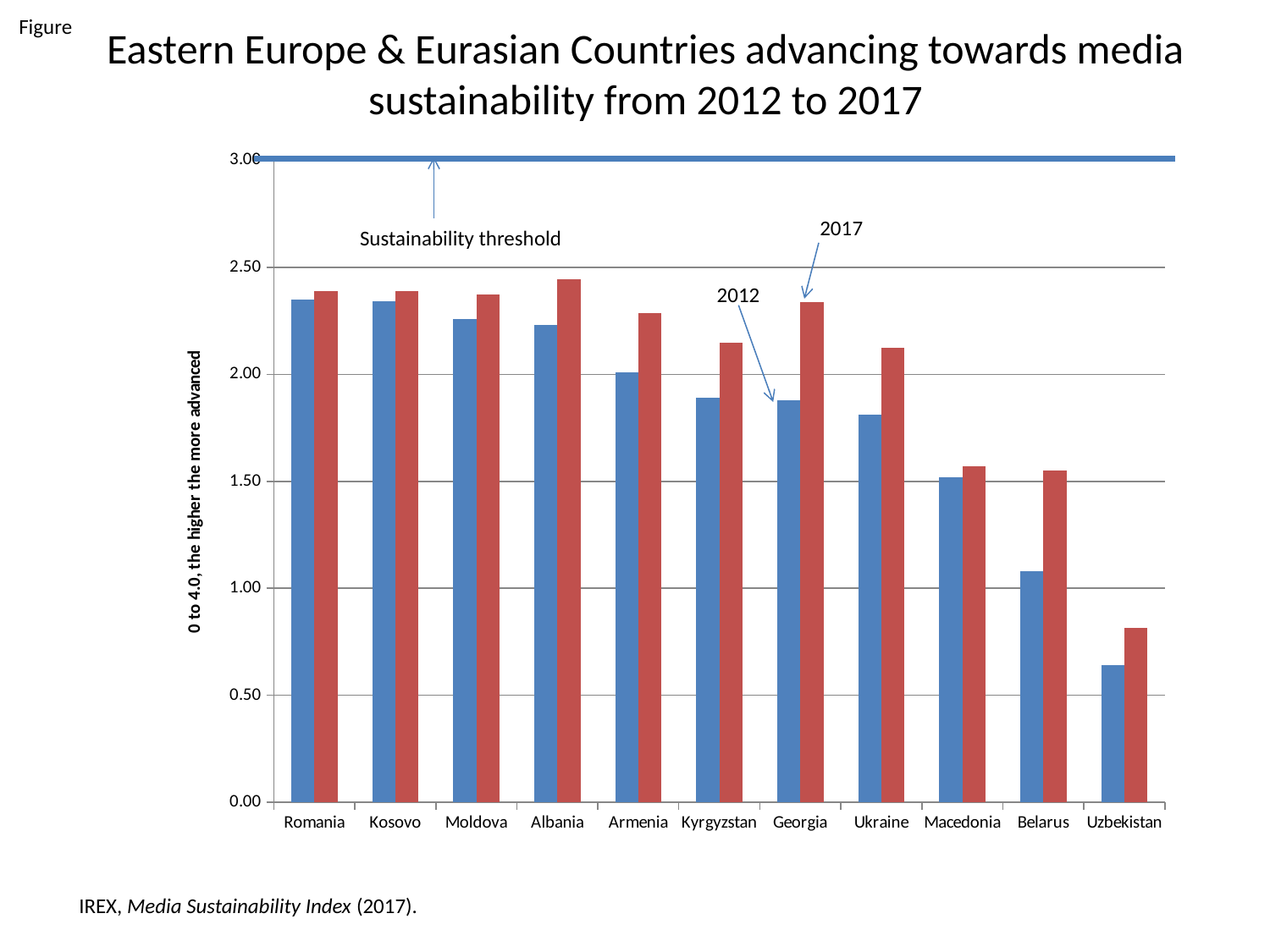
What kind of chart is shown on the slide? bar chart Is the 2012 value for Ukraine greater or less than 2.00? less Is the 2017 value for Albania greater or less than 2.50? less How many data series (years) are plotted for each country? 2 For Georgia, which is larger, the 2012 value or the 2017 value? 2017 Is the 2017 value for Georgia greater or less than 2.00? greater How many countries are shown on the x axis of the chart? 11 Which country has the highest 2017 value? Albania Which country has the lowest 2017 value? Uzbekistan Do the values generally rise or fall moving from Romania on the left to Uzbekistan on the right? fall At what value on the y axis is the sustainability threshold line drawn? 3.00